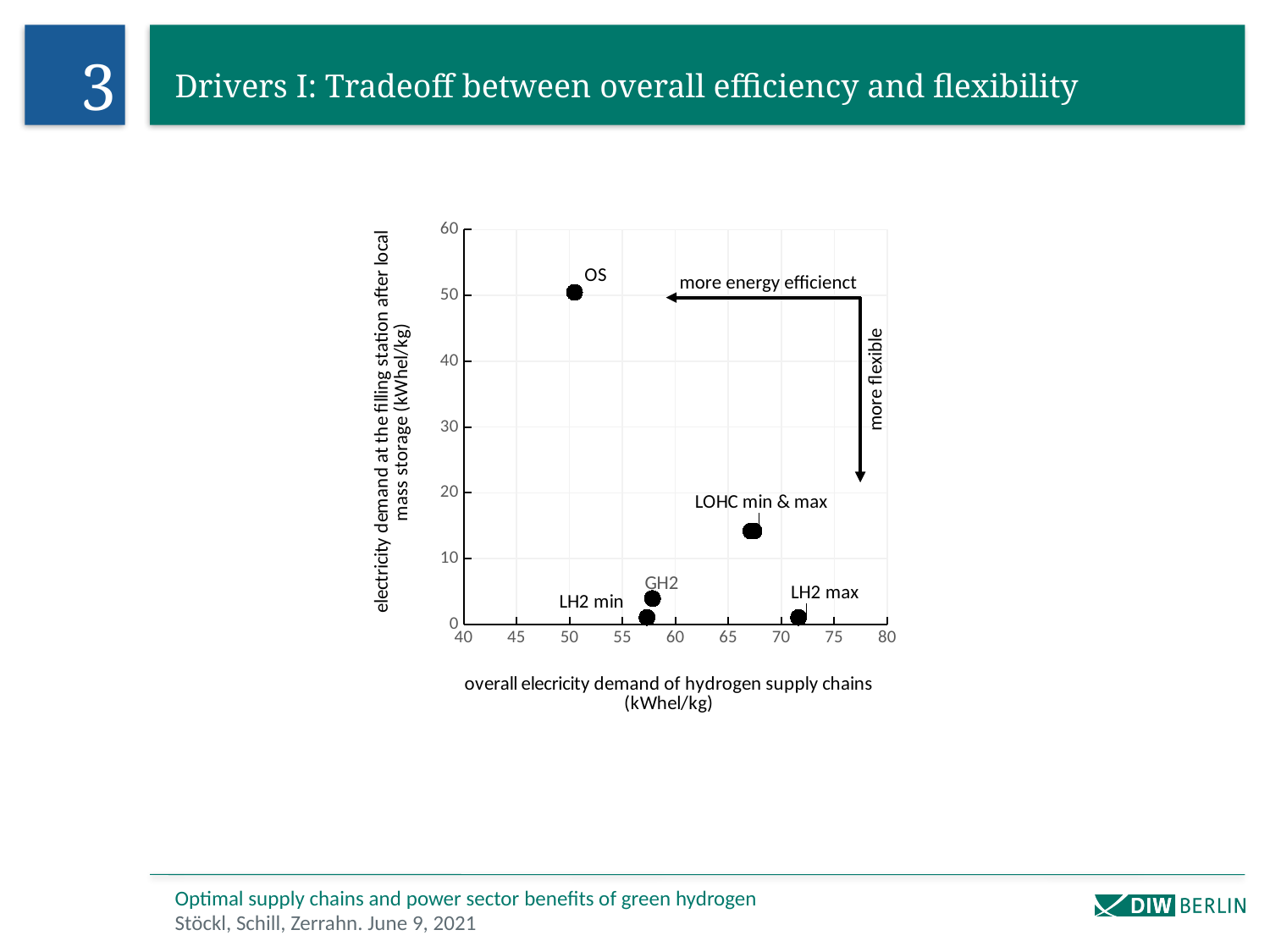
Is the overall electricity demand for OS greater or less than 55 kWhel/kg? less Which labelled point has the highest electricity demand at the filling station after local mass storage? OS What kind of chart is shown on the slide? scatter chart Which labelled point has the highest overall electricity demand of hydrogen supply chains? LH2 max What is the title of the x axis of the chart? overall elecricity demand of hydrogen supply chains (kWhel/kg) Which has the higher overall electricity demand, LH2 max or LH2 min? LH2 max Is the overall electricity demand for LH2 max greater or less than 65 kWhel/kg? greater Which labelled point has the lowest overall electricity demand of hydrogen supply chains? OS Is the electricity demand at the filling station for LOHC min & max greater or less than 20 kWhel/kg? less Which has the higher electricity demand at the filling station, OS or LOHC min & max? OS